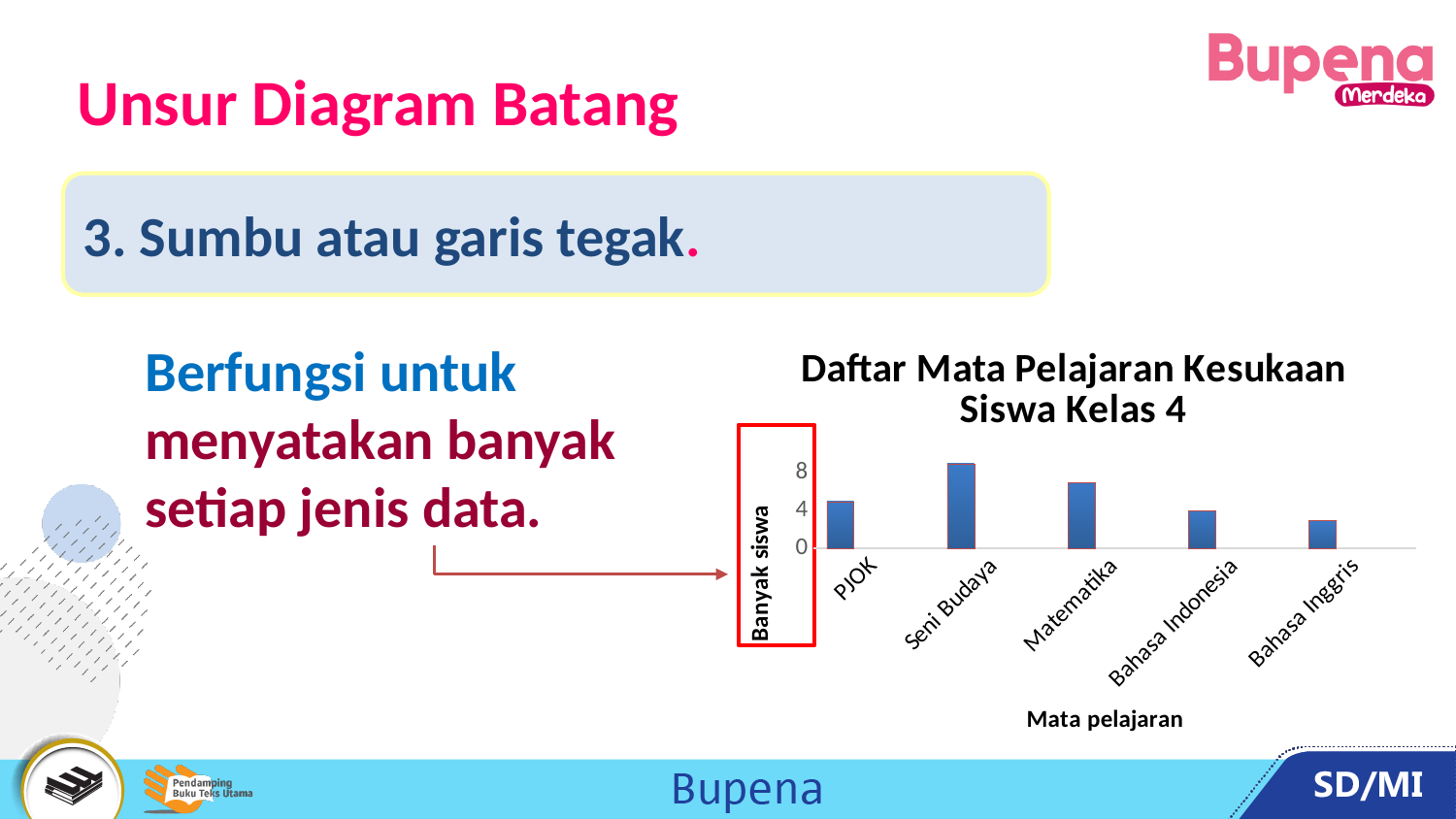
Which is larger, the value for Seni Budaya or the value for PJOK? Seni Budaya What is the title of the chart? Daftar Mata Pelajaran Kesukaan Siswa Kelas 4 How many subjects (categories) are shown on the x axis of the chart? 5 Is the value for Matematika greater or less than 8? less Is the value for Bahasa Inggris greater or less than 4? less Is the value for Seni Budaya greater or less than 8? greater What type of chart is shown on the slide? bar chart What is the label of the vertical axis of the chart? Banyak siswa Which subject has the lowest bar in the chart? Bahasa Inggris Which is larger, the value for Matematika or the value for Bahasa Inggris? Matematika Which subject has the highest bar in the chart? Seni Budaya